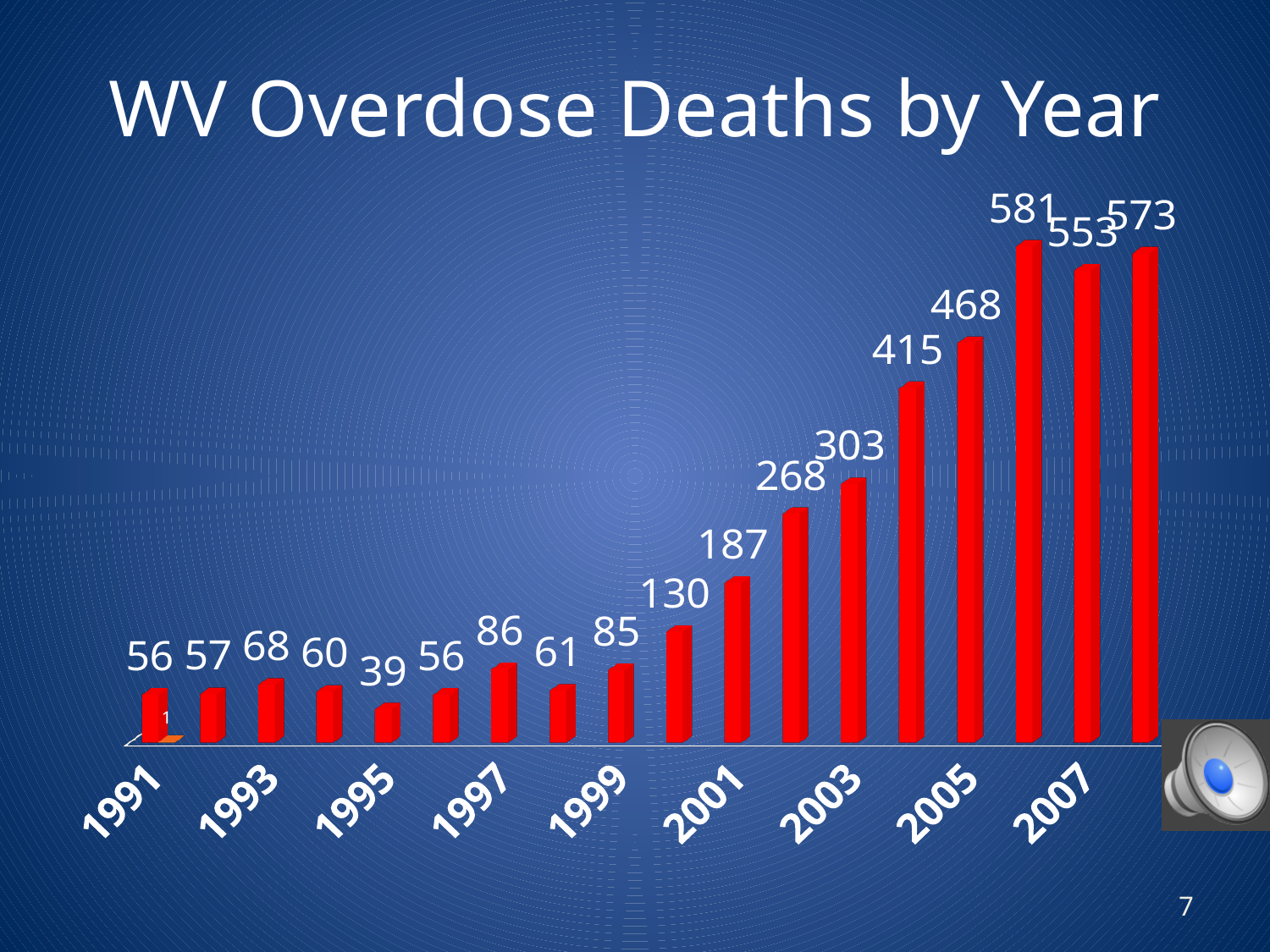
How many bars are plotted in the chart? 18 Which year has the lowest number of overdose deaths? 1995 What is the value for 1995? 39 What is the highest value labelled on the chart? 581 What is the value for 2001? 187 What type of chart is shown on the slide? bar chart What is the value for 2005? 468 What is the difference between the values for 2003 and 2001? 116 Do the values generally rise or fall from 1999 to 2007? rise What is the title of the chart? WV Overdose Deaths by Year How many overdose deaths are shown for 1991? 56 Which year has the larger value, 1997 or 1999? 1997